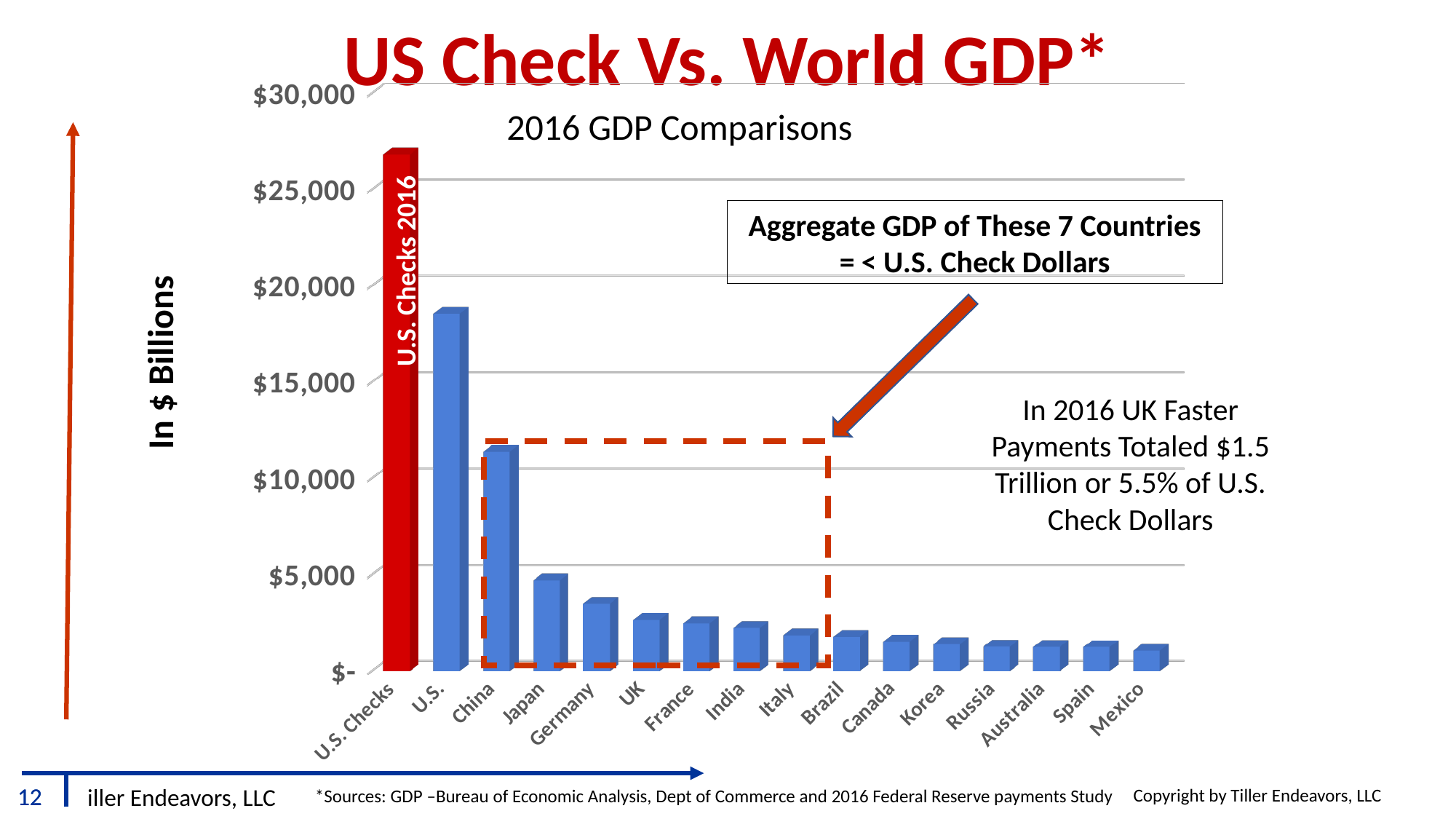
Do the bar values generally rise or fall moving from left to right along the x axis? fall How many categories are plotted along the x axis of the chart? 16 Which category has the highest bar in the chart? U.S. Checks What is the title of the chart? 2016 GDP Comparisons Is the value for U.S. greater or less than $20,000? less Is the value for Germany greater or less than $5,000? less What kind of chart is shown on the slide? bar chart Is the value for U.S. Checks greater or less than $25,000? greater Which is larger, the value for U.S. or the value for China? U.S. Which category has the lowest bar in the chart? Mexico What is the label on the vertical axis of the chart? In $ Billions